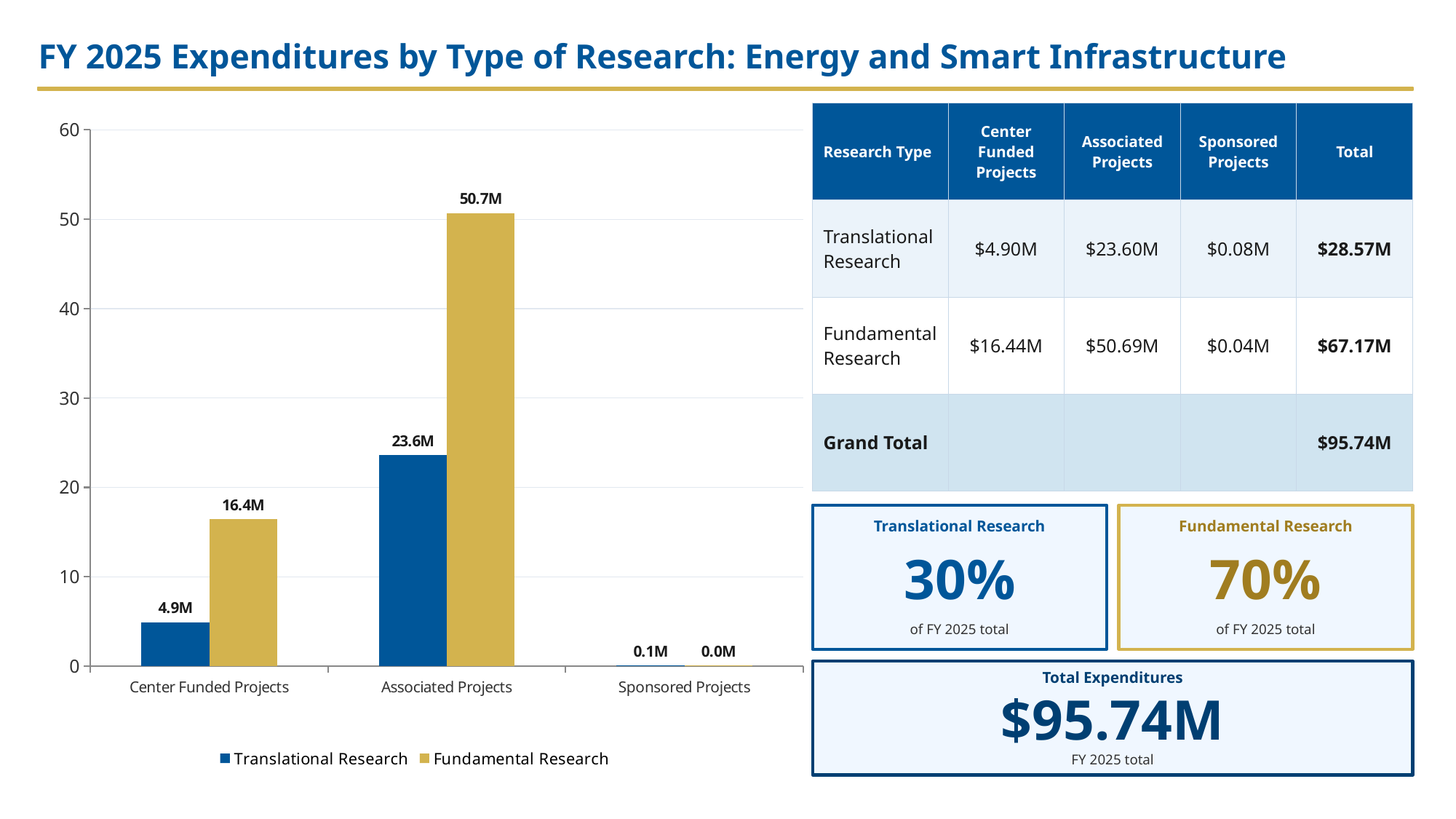
How many categories are shown on the x axis of the bar chart? 3 In the bar chart, is the Fundamental Research value for Associated Projects greater or less than 40? greater What is the Translational Research value for Sponsored Projects in the bar chart? 0.1M Which category has the lowest Translational Research value in the bar chart? Sponsored Projects What is the Translational Research value for Center Funded Projects in the bar chart? 4.9M Which colour represents Fundamental Research in the bar chart? gold In the bar chart, which is larger for Center Funded Projects: Translational Research or Fundamental Research? Fundamental Research In the bar chart, what is the difference between the Fundamental Research and Translational Research values for Associated Projects? 27.1M How many series does the legend of the bar chart list? 2 Which category has the highest Fundamental Research value in the bar chart? Associated Projects What kind of chart is shown on the slide? bar chart What is the Fundamental Research value for Associated Projects in the bar chart? 50.7M